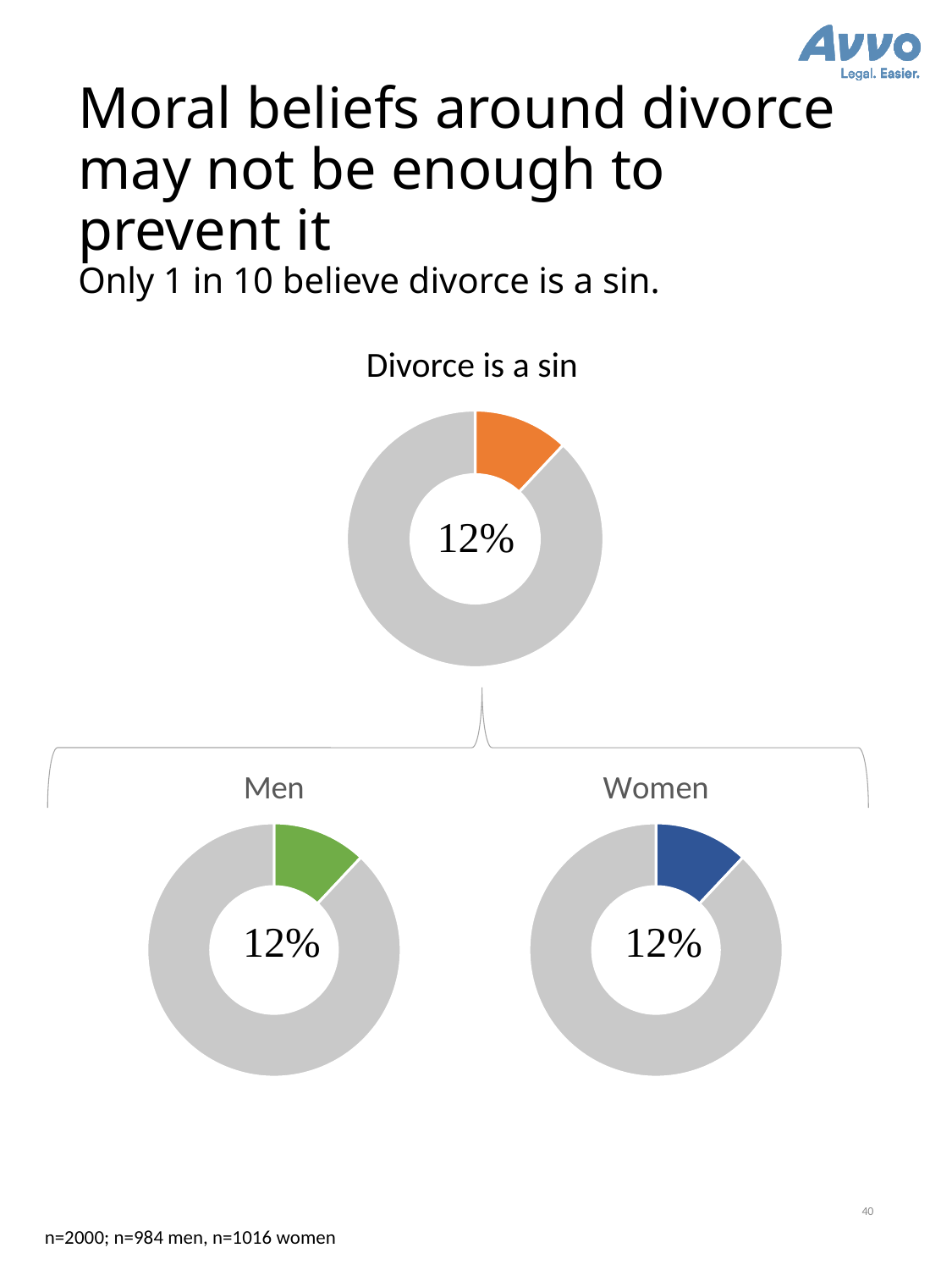
In the 'Divorce is a sin' chart at the top, what percentage is shown in the centre of the doughnut? 12% In the 'Women' chart at the bottom right, what percentage is shown? 12% In the 'Men' chart at the bottom left, what colour is the highlighted slice? Green What is the title of the top chart on the slide? Divorce is a sin How many doughnut charts are shown on the slide? 3 In the 'Divorce is a sin' chart at the top, what share of the doughnut does the orange slice represent? 12% What kind of chart is the 'Divorce is a sin' chart at the top of the slide? Doughnut chart In the 'Women' chart at the bottom right, what share of the doughnut does the blue slice represent? 12% Is the percentage shown in the 'Men' chart larger than, smaller than, or equal to the percentage shown in the 'Women' chart? Equal In the 'Men' chart at the bottom left, what percentage is shown? 12% What is the difference between the percentage shown in the 'Men' chart and the percentage shown in the 'Women' chart? 0%